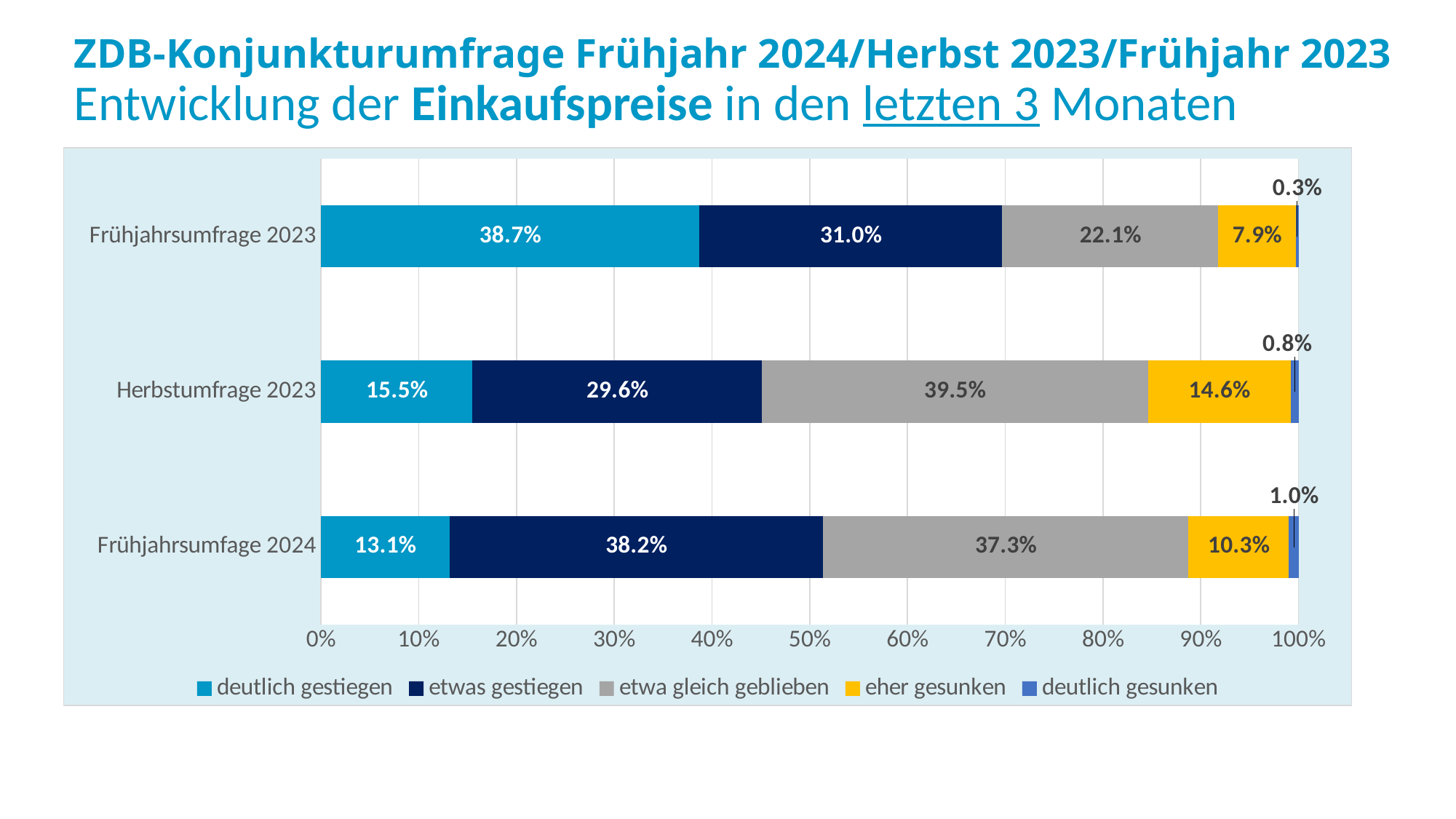
What is the value for 'deutlich gesunken' in the Frühjahrsumfage 2024? 1.0% What is the value for 'deutlich gestiegen' in the Frühjahrsumfrage 2023? 38.7% What is the value for 'etwa gleich geblieben' in the Herbstumfrage 2023? 39.5% What is the total of the stacked bar for the Frühjahrsumfrage 2023? 100.0% How many series does the legend list? 5 How many surveys (categories) are shown in the chart? 3 What is the difference between the 'deutlich gestiegen' values of the Frühjahrsumfrage 2023 and the Herbstumfrage 2023? 23.2 percentage points Which survey has the lowest value for 'eher gesunken'? Frühjahrsumfrage 2023 In the Herbstumfrage 2023, which is larger: 'etwas gestiegen' or 'etwa gleich geblieben'? etwa gleich geblieben What is the value for 'eher gesunken' in the Herbstumfrage 2023? 14.6% What kind of chart is shown on the slide? Stacked bar chart Which survey has the highest value for 'deutlich gestiegen'? Frühjahrsumfrage 2023